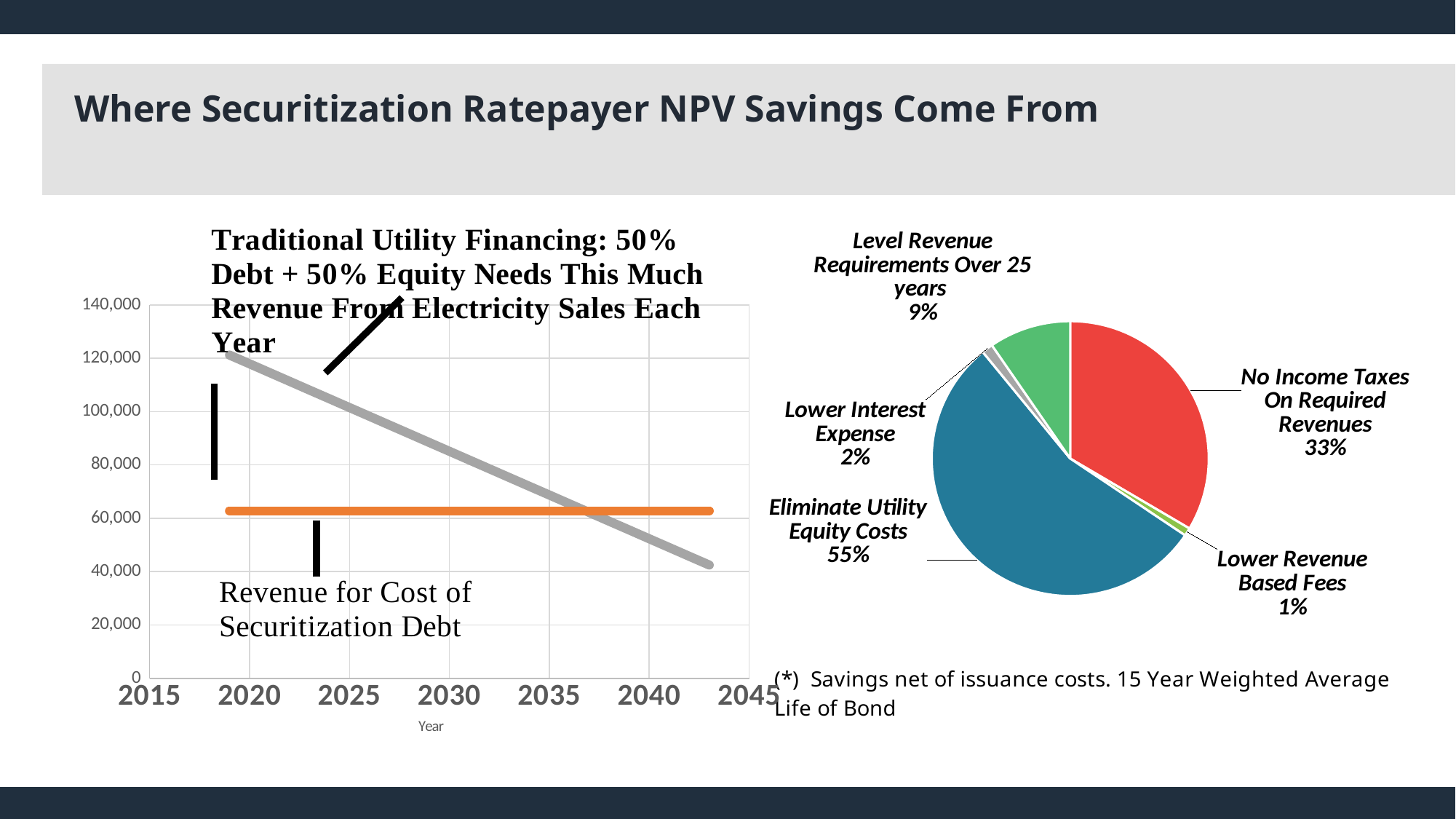
In the pie chart on the right, how many slices are there? 5 What kind of chart is on the left side of the slide? Line chart In the chart on the left, does the gray line for traditional utility financing rise or fall from 2020 to 2045? Fall In the pie chart on the right, which slice is the largest? Eliminate Utility Equity Costs In the pie chart on the right, what is the difference in percentage points between Eliminate Utility Equity Costs and No Income Taxes On Required Revenues? 22 percentage points In the pie chart on the right, what share is labelled for Level Revenue Requirements Over 25 years? 9% In the pie chart on the right, which slice is the smallest? Lower Revenue Based Fees In the pie chart on the right, what share is labelled for No Income Taxes On Required Revenues? 33% In the chart on the left, is the orange line for Revenue for Cost of Securitization Debt greater or less than 80,000? less In the pie chart on the right, what share is labelled for Eliminate Utility Equity Costs? 55% In the pie chart on the right, which is larger: Lower Interest Expense or Level Revenue Requirements Over 25 years? Level Revenue Requirements Over 25 years In the chart on the left, is the value of the gray traditional utility financing line in 2020 greater or less than 100,000? greater